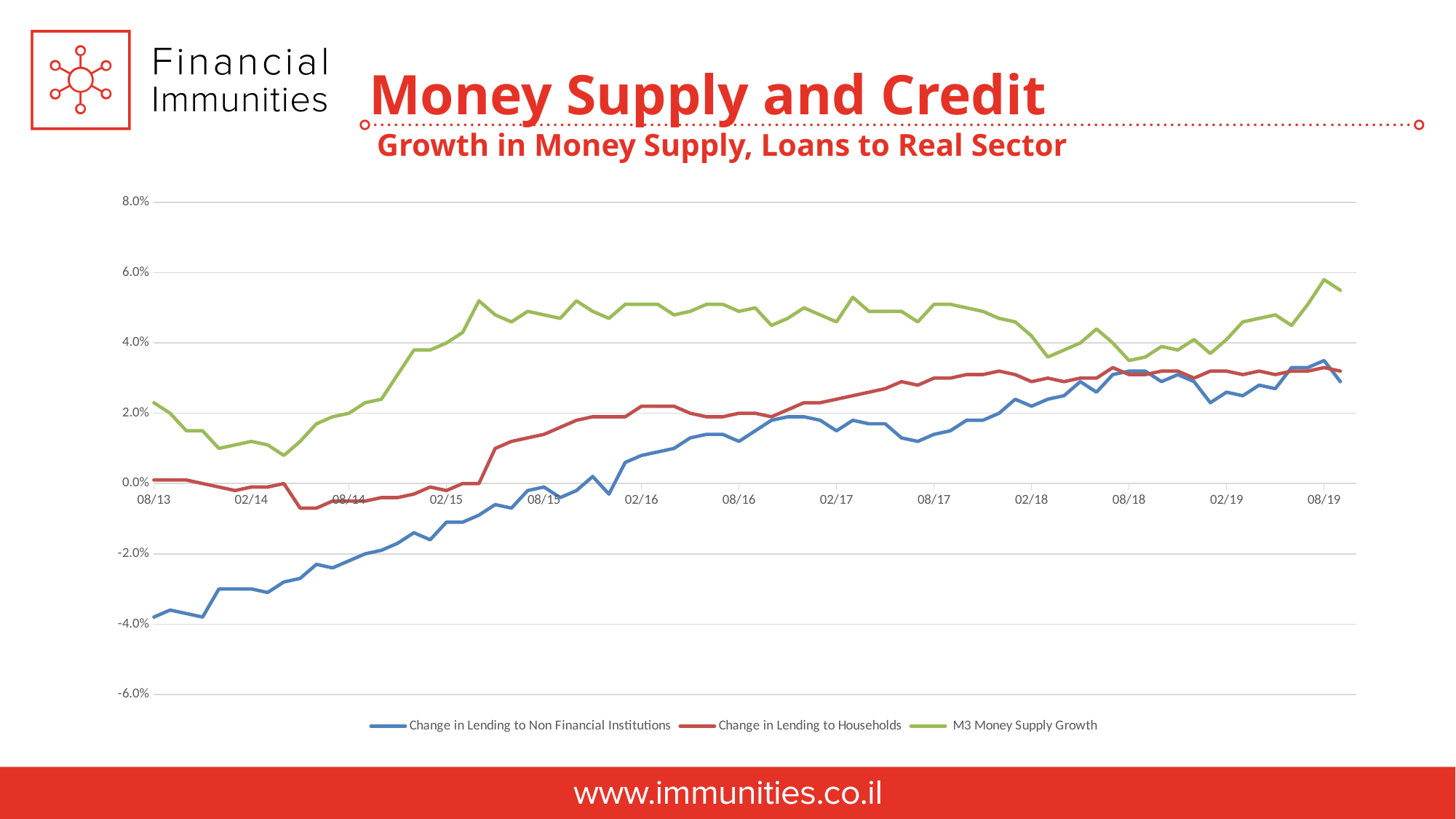
What is the subtitle of the chart? Growth in Money Supply, Loans to Real Sector Is the value for Change in Lending to Households at 08/13 greater or less than 2.0%? less Which series is shown in green in the legend? M3 Money Supply Growth Which series has the highest value at 08/19? M3 Money Supply Growth At 08/13, which is higher: M3 Money Supply Growth or Change in Lending to Non Financial Institutions? M3 Money Supply Growth Which series has the lowest value at 08/13? Change in Lending to Non Financial Institutions Is the value for Change in Lending to Non Financial Institutions at 08/13 greater or less than -2.0%? less Is the value for M3 Money Supply Growth at 08/16 greater or less than 4.0%? greater Does the Change in Lending to Non Financial Institutions line rise or fall overall from 08/13 to 08/19? rise What kind of chart is shown on the slide? line chart How many series does the legend list? 3